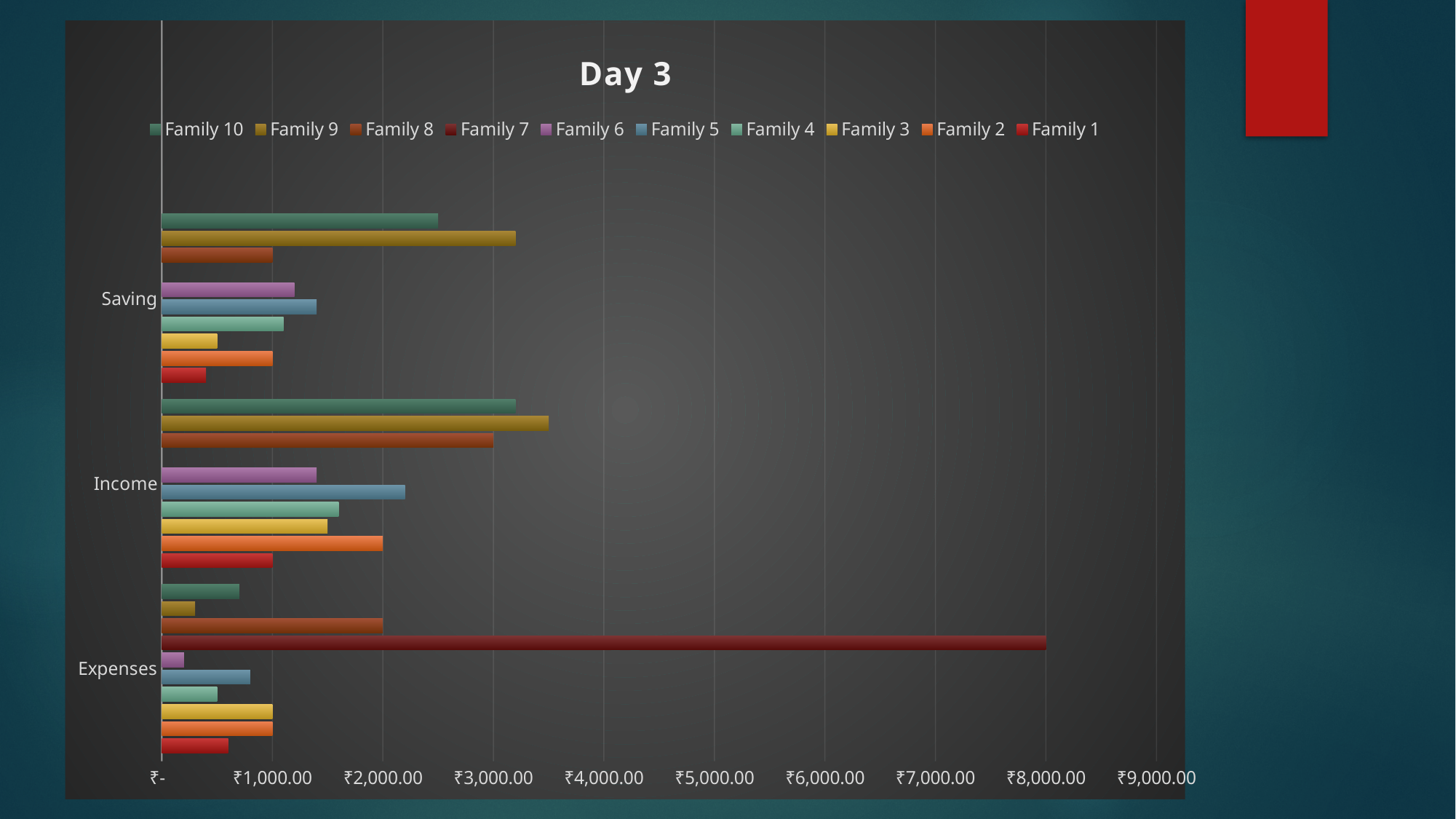
Is the Income value for Family 9 greater or less than ₹3,000.00? greater What is the Expenses value for Family 7? ₹8,000.00 What is the Income value for Family 8? ₹3,000.00 For Income, which is larger: Family 5 or Family 6? Family 5 What is the title of the chart? Day 3 Is the Saving value for Family 10 greater or less than ₹2,000.00? greater What kind of chart is shown on the slide? bar chart Which family has the lowest Expenses value? Family 6 For Saving, which is larger: Family 9 or Family 10? Family 9 How many categories are shown on the vertical axis? 3 How many series does the legend list? 10 Which family has the highest Expenses value? Family 7